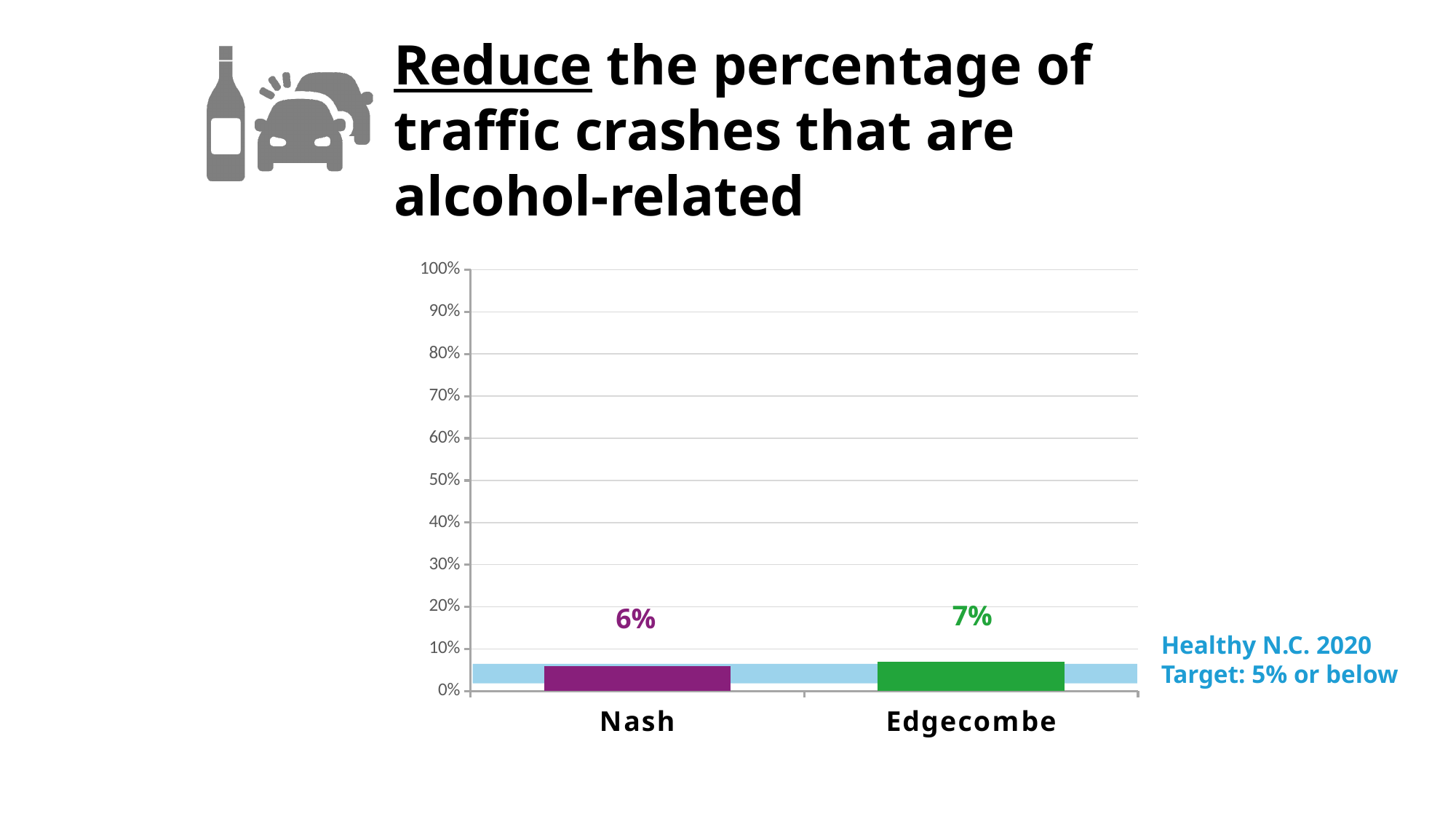
Which county has the higher percentage of alcohol-related traffic crashes? Edgecombe What is the percentage of alcohol-related traffic crashes for Nash? 6% How many counties are shown on the chart? 2 Is the value for Nash greater or less than 10%? less What is the percentage of alcohol-related traffic crashes for Edgecombe? 7% What is the highest value shown on the y axis? 100% What is the Healthy N.C. 2020 target shown on the chart? 5% or below What is the difference between Edgecombe's and Nash's percentages of alcohol-related traffic crashes? 1% Is the value for Edgecombe greater or less than 50%? less Which county has the lower percentage of alcohol-related traffic crashes? Nash What kind of chart is shown on the slide? Bar chart